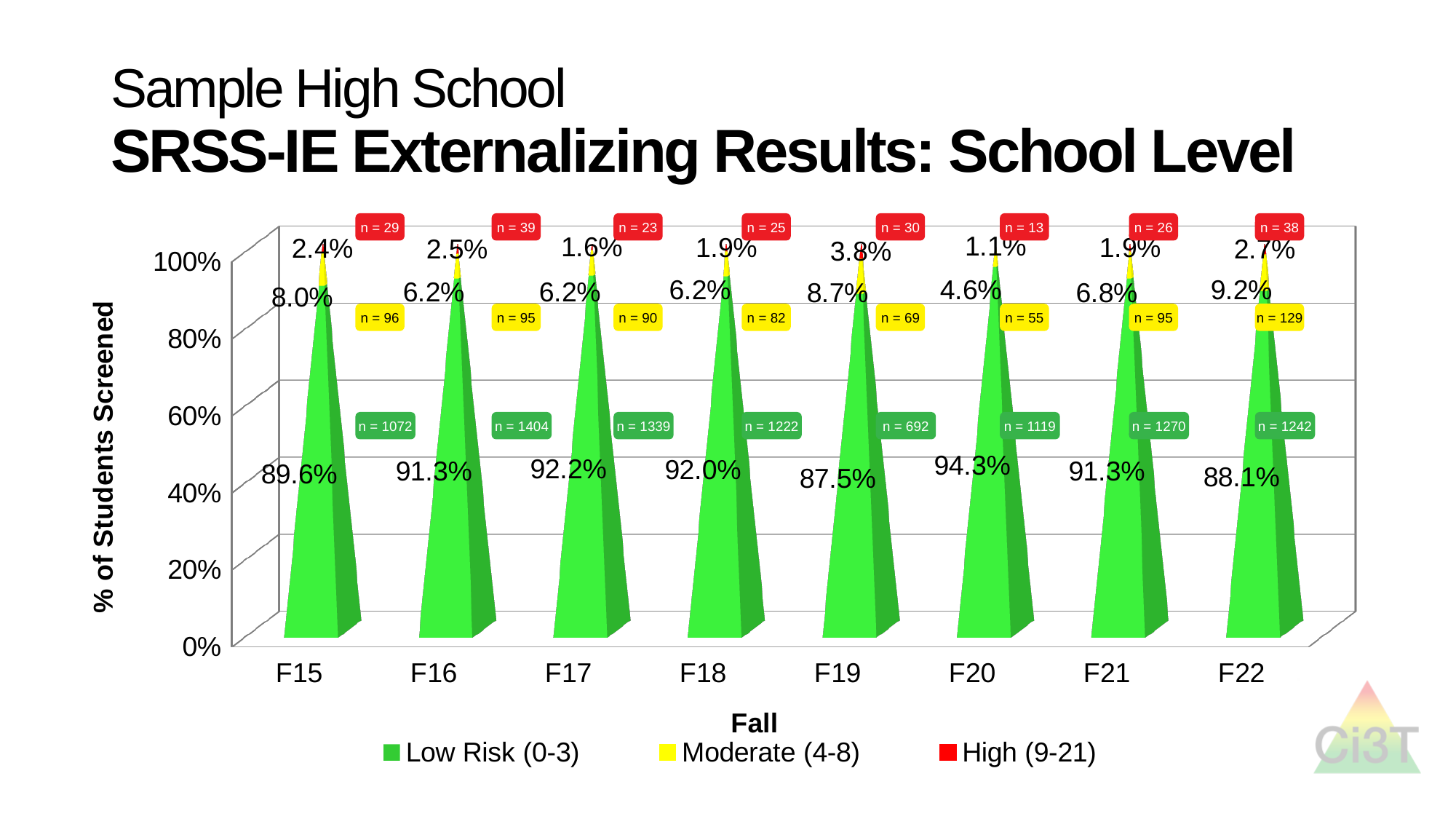
What is the title of the y axis? % of Students Screened How many series does the legend list? 3 Which is larger, the Moderate (4-8) percentage for F15 or for F21? F15 Which fall has the lowest Low Risk (0-3) percentage? F19 What is the Low Risk (0-3) percentage for F15? 89.6% How many fall screening periods are shown on the x axis? 8 Which fall has the lowest High (9-21) percentage? F20 How many students were in the Low Risk (0-3) group in F16? n = 1404 What is the Moderate (4-8) percentage for F22? 9.2% What is the High (9-21) percentage for F19? 3.8% What is the difference between the Low Risk (0-3) percentages for F20 and F19? 6.8% Which fall has the highest Low Risk (0-3) percentage? F20